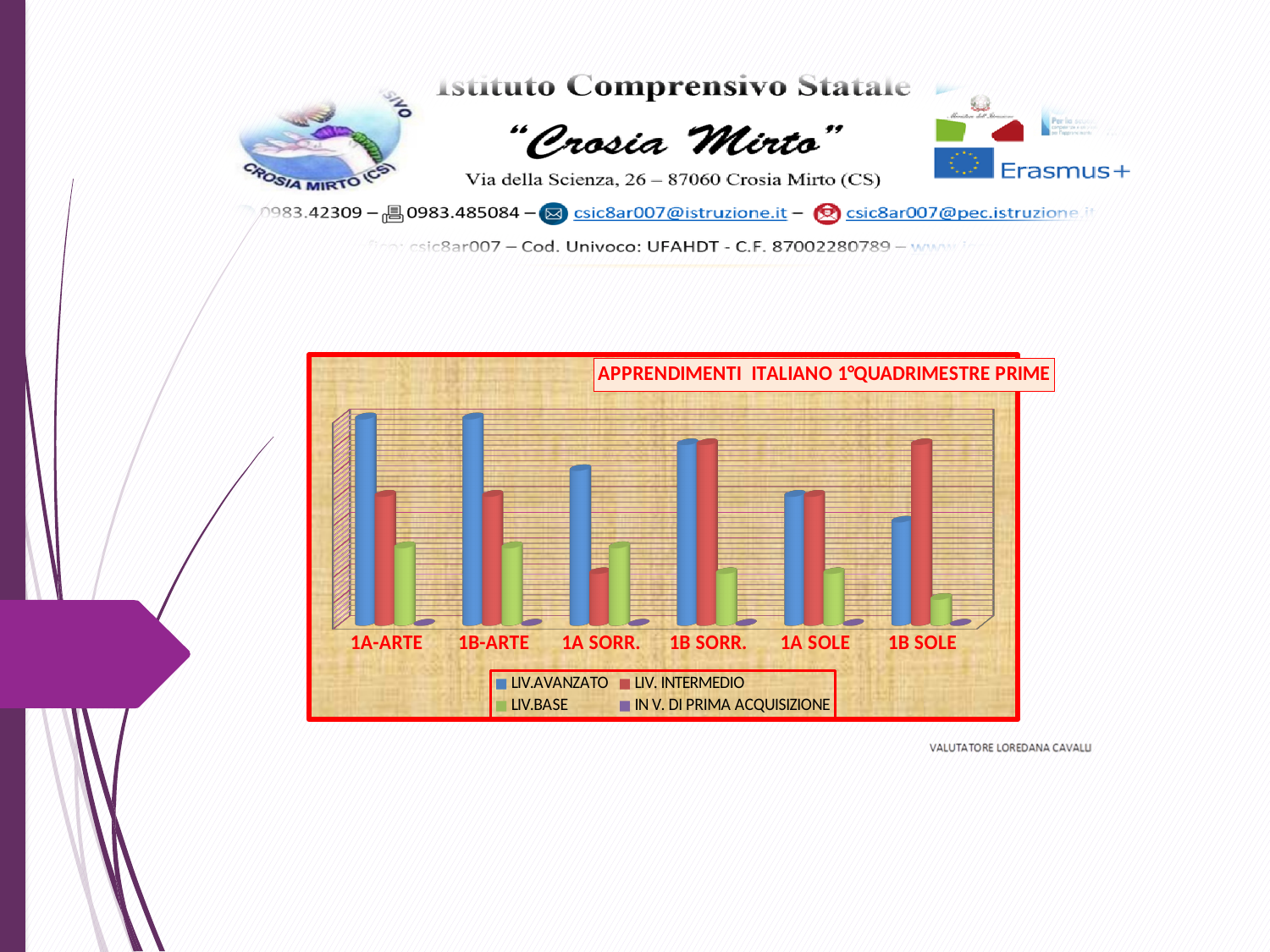
Which class has the lowest LIV. INTERMEDIO value? 1A SORR. Which class has the lowest LIV.AVANZATO value? 1B SOLE What kind of chart is shown on the slide? bar chart How many classes (categories) are shown on the x axis of the chart? 6 For 1A-ARTE, which is larger: LIV.AVANZATO or LIV. INTERMEDIO? LIV.AVANZATO Which class has the lowest LIV.BASE value? 1B SOLE For 1B SOLE, which is larger: LIV.AVANZATO or LIV. INTERMEDIO? LIV. INTERMEDIO Which series is shown in red in the chart? LIV. INTERMEDIO What is the title of the chart? APPRENDIMENTI ITALIANO 1°QUADRIMESTRE PRIME How many series does the chart's legend list? 4 For 1A SORR., which is larger: LIV. INTERMEDIO or LIV.BASE? LIV.BASE